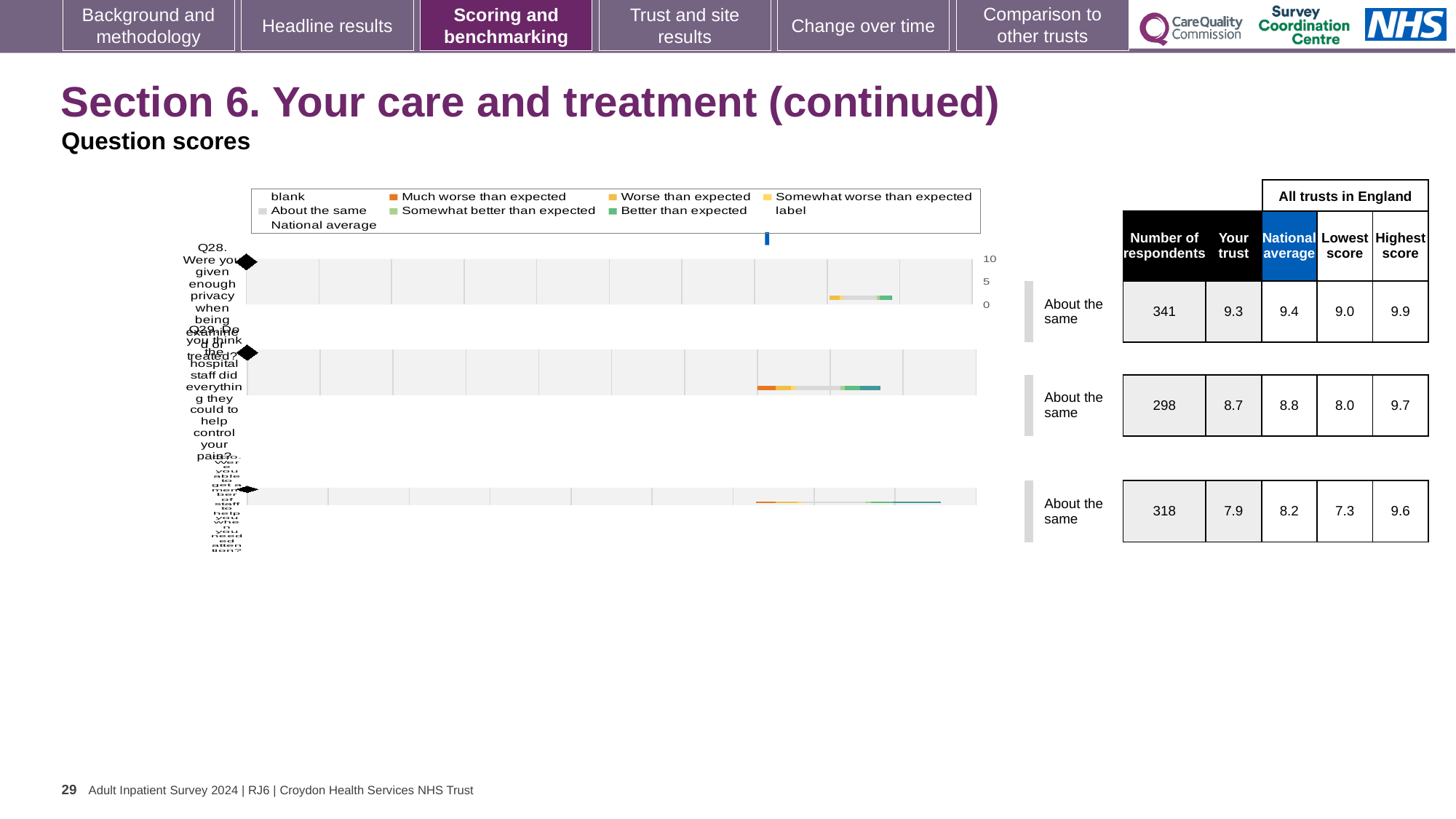
For Q30, what is the difference between the national average and the 'Your trust' score? 0.3 What kind of chart is used to show the question scores on this slide? Bar chart What is the 'Your trust' score for Q28 (privacy when being examined or treated)? 9.3 What is the national average score for Q29 (hospital staff did everything to help control pain)? 8.8 How many respondents answered Q30 (able to get a member of staff to help when needed)? 318 How many questions are plotted in the question scores chart? 3 Which question has the lowest 'Your trust' score? Q30 Which question has the highest 'Your trust' score? Q28 For Q29, which is larger: the 'Your trust' score or the national average? National average What benchmark category is shown for all three questions on this slide? About the same What is the lowest score across all trusts in England for Q30? 7.3 For Q28, what is the difference between the highest score and the lowest score across all trusts in England? 0.9